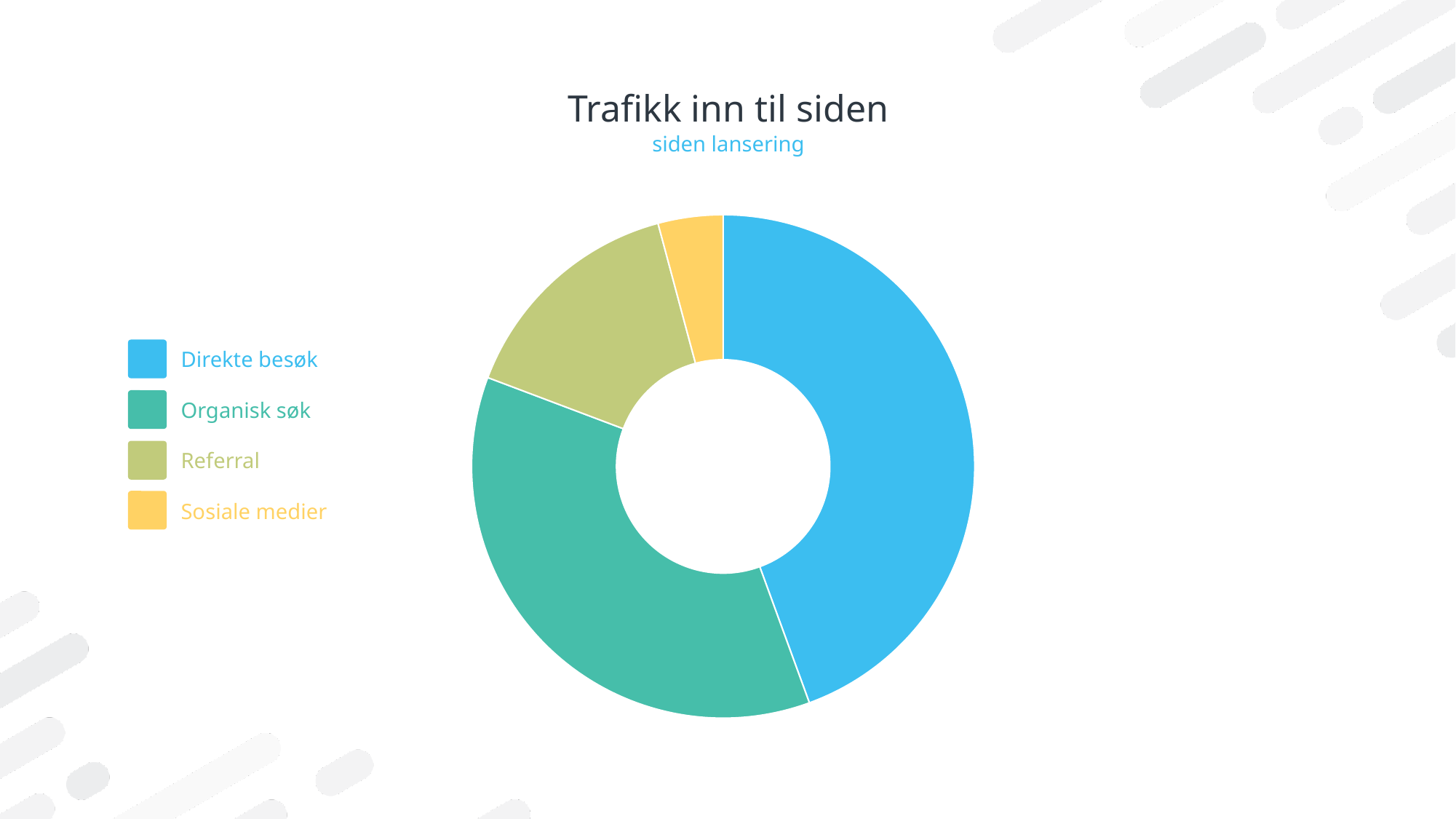
What kind of chart is shown on the slide? donut chart Which slice is larger, Direkte besøk or Organisk søk? Direkte besøk Which category has the smallest slice of the chart? Sosiale medier Which category has the largest slice of the chart? Direkte besøk Which slice is larger, Referral or Sosiale medier? Referral What is the subtitle shown under the chart title? siden lansering Which slice is larger, Organisk søk or Referral? Organisk søk What is the title of the chart? Trafikk inn til siden How many categories does the chart show? 4